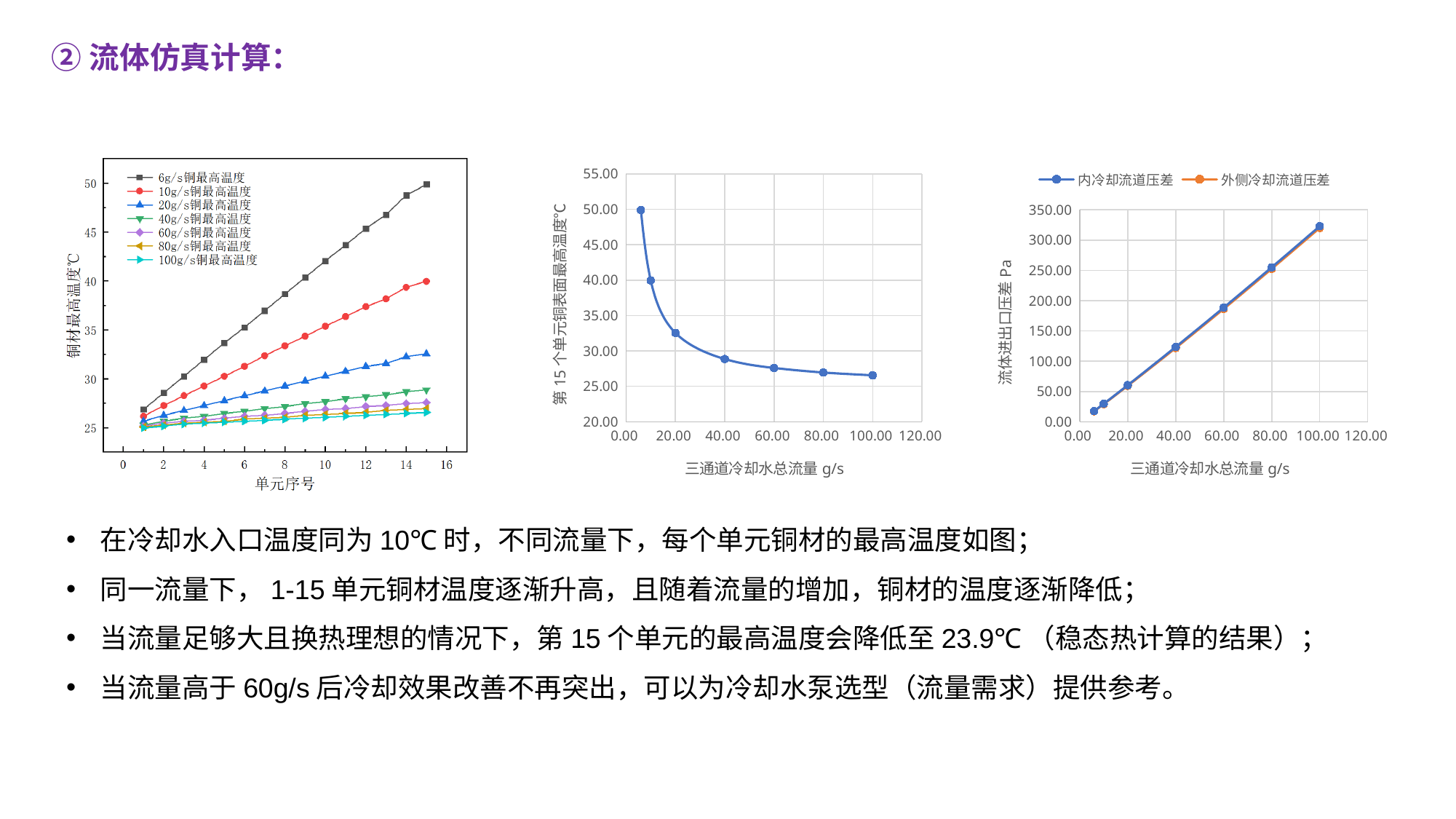
In the right chart, do the values of 内冷却流道压差 rise or fall as 三通道冷却水总流量 increases? rise In the middle chart, is the value at 100.00 g/s greater or less than 30.00? less In the middle chart, do the values rise or fall as 三通道冷却水总流量 increases? fall In the left chart, how many series does the legend list? 7 In the right chart, how many series does the legend list? 2 In the left chart, do the values of the 6g/s铜最高温度 series rise or fall as 单元序号 increases? rise What kind of chart is the left chart (铜材最高温度 vs 单元序号)? line chart In the left chart, which series has the highest temperature at 单元序号 15? 6g/s铜最高温度 In the middle chart, how many data points are plotted? 7 In the right chart, is the value of 内冷却流道压差 at 100.00 g/s greater or less than 300.00? greater In the left chart, at 单元序号 15, which is larger: 10g/s铜最高温度 or 20g/s铜最高温度? 10g/s铜最高温度 In the left chart, is the value of 6g/s铜最高温度 at 单元序号 15 greater or less than 45? greater